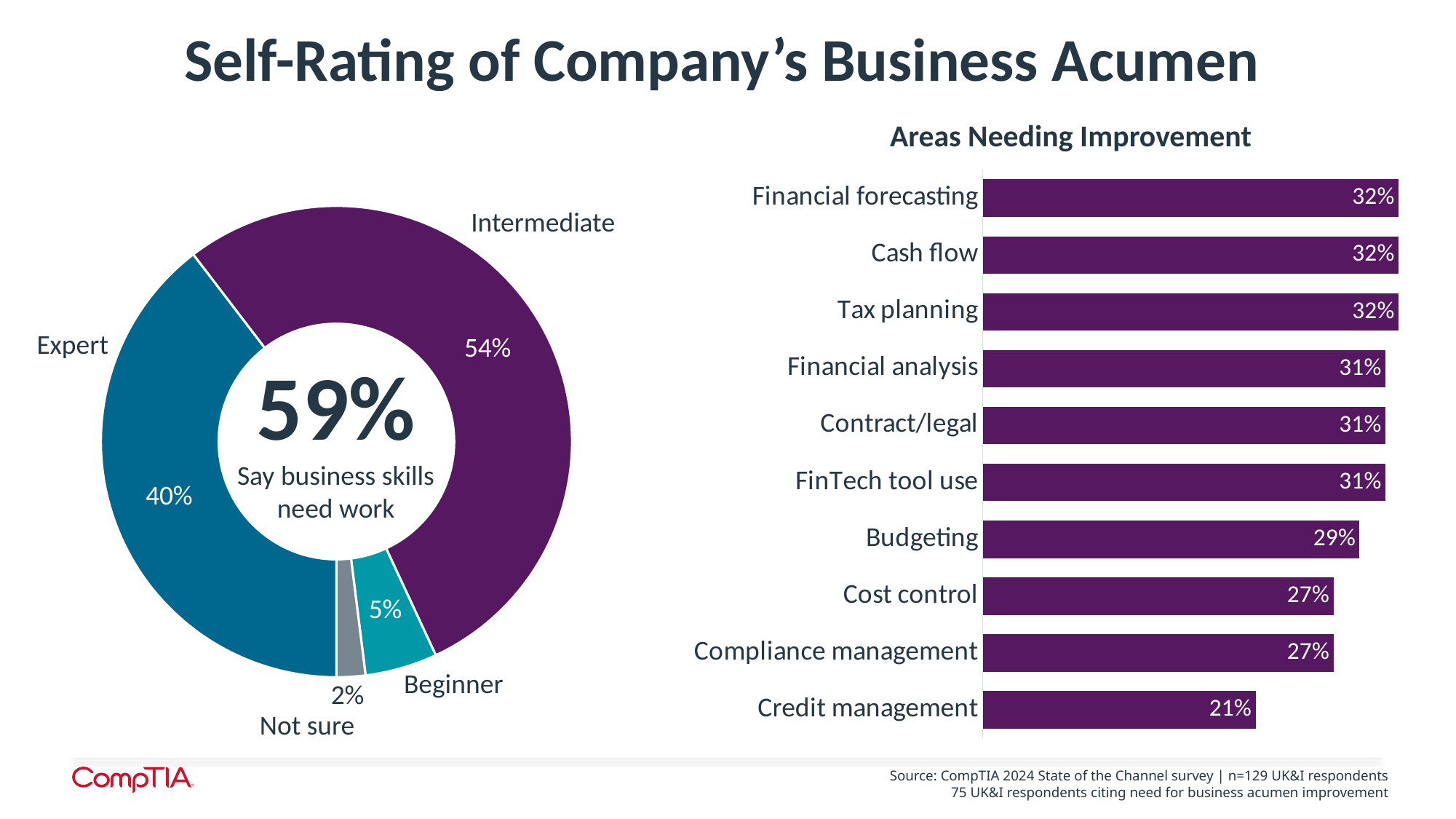
In the donut chart on the left, what percentage rated their company as Expert? 40% In the donut chart on the left, which category has the largest share? Intermediate In the 'Areas Needing Improvement' chart, what is the value for Budgeting? 29% In the donut chart on the left, how many categories are shown? 4 What kind of chart is 'Areas Needing Improvement'? Bar chart In the 'Areas Needing Improvement' chart, which area has the lowest value? Credit management In the donut chart on the left, which category has the smallest share? Not sure In the donut chart on the left, what percentage of respondents rated their company's business acumen as Intermediate? 54% What percentage is shown in the centre of the donut chart as saying business skills need work? 59% In the 'Areas Needing Improvement' chart, how many areas are listed? 10 In the donut chart on the left, what is the difference between the Intermediate and Expert shares? 14 percentage points In the 'Areas Needing Improvement' chart, what is the difference between Financial forecasting and Credit management? 11 percentage points